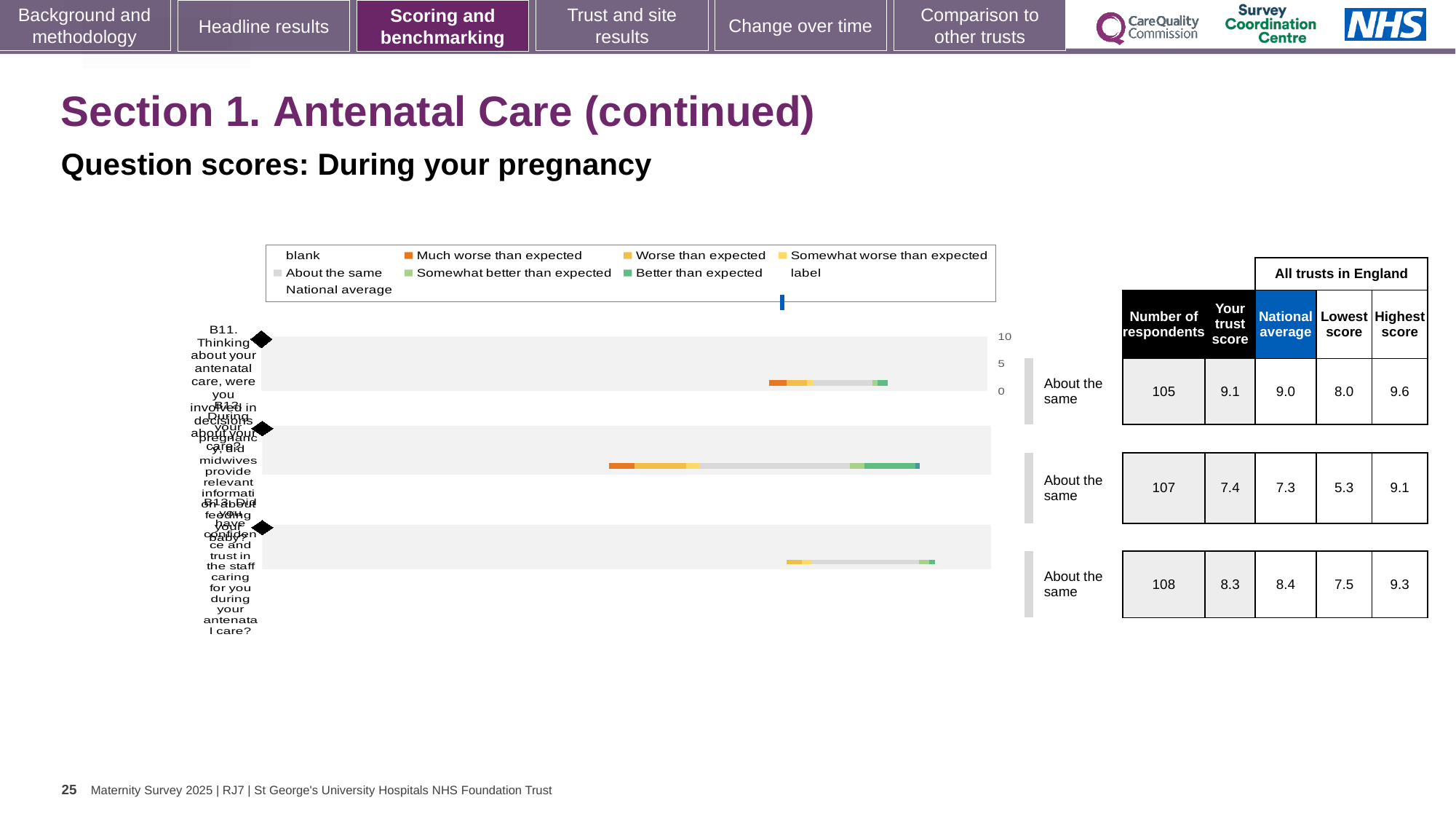
What is the highest score across all trusts in England for question B13? 9.3 What is the national average for question B13 (confidence and trust in the staff caring for you during antenatal care)? 8.4 What kind of chart is shown on the slide? bar chart Which question has the highest trust score? B11 What benchmark category is shown for question B12? About the same What is the number of respondents for question B11? 105 How many questions (bars) are plotted in the chart? 3 What colour represents 'Much worse than expected' in the legend? orange For question B13, which is larger: the trust score or the national average? national average What is the trust score for question B12 (did midwives provide relevant information about feeding your baby)? 7.4 What is the difference between the highest score and the lowest score for question B11? 1.6 Which question has the lowest 'Lowest score' across all trusts in England? B12